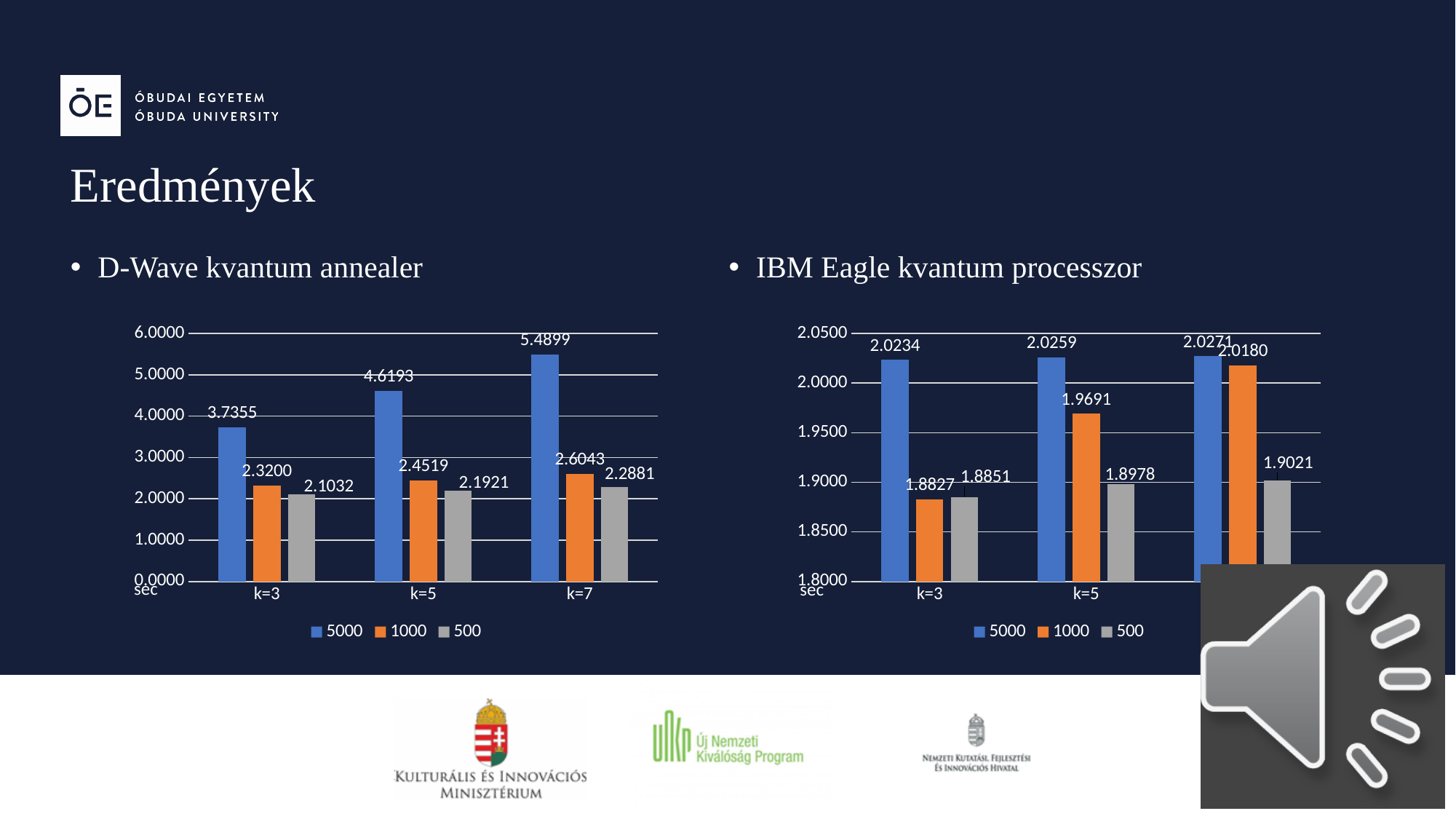
In the IBM Eagle kvantum processzor chart, what is the value for the 1000 series at k=5? 1.9691 In the D-Wave kvantum annealer chart, at which k value is the 5000 series highest? k=7 In the IBM Eagle kvantum processzor chart, which series has the lowest value at k=3? 1000 In the IBM Eagle kvantum processzor chart, at k=5, which is larger: the 1000 series or the 500 series? 1000 What kind of chart is the D-Wave kvantum annealer chart? bar chart In the D-Wave kvantum annealer chart, what is the value for the 5000 series at k=7? 5.4899 In the D-Wave kvantum annealer chart, what is the difference between the 5000 and 1000 values at k=3? 1.4155 In the D-Wave kvantum annealer chart, is the value for the 1000 series at k=7 greater or less than 3.0000? less In the D-Wave kvantum annealer chart, does the 5000 series rise or fall from k=3 to k=7? rise How many k categories are shown on the x axis of the D-Wave kvantum annealer chart? 3 How many series does the legend of the IBM Eagle kvantum processzor chart list? 3 In the D-Wave kvantum annealer chart, what is the value for the 500 series at k=5? 2.1921